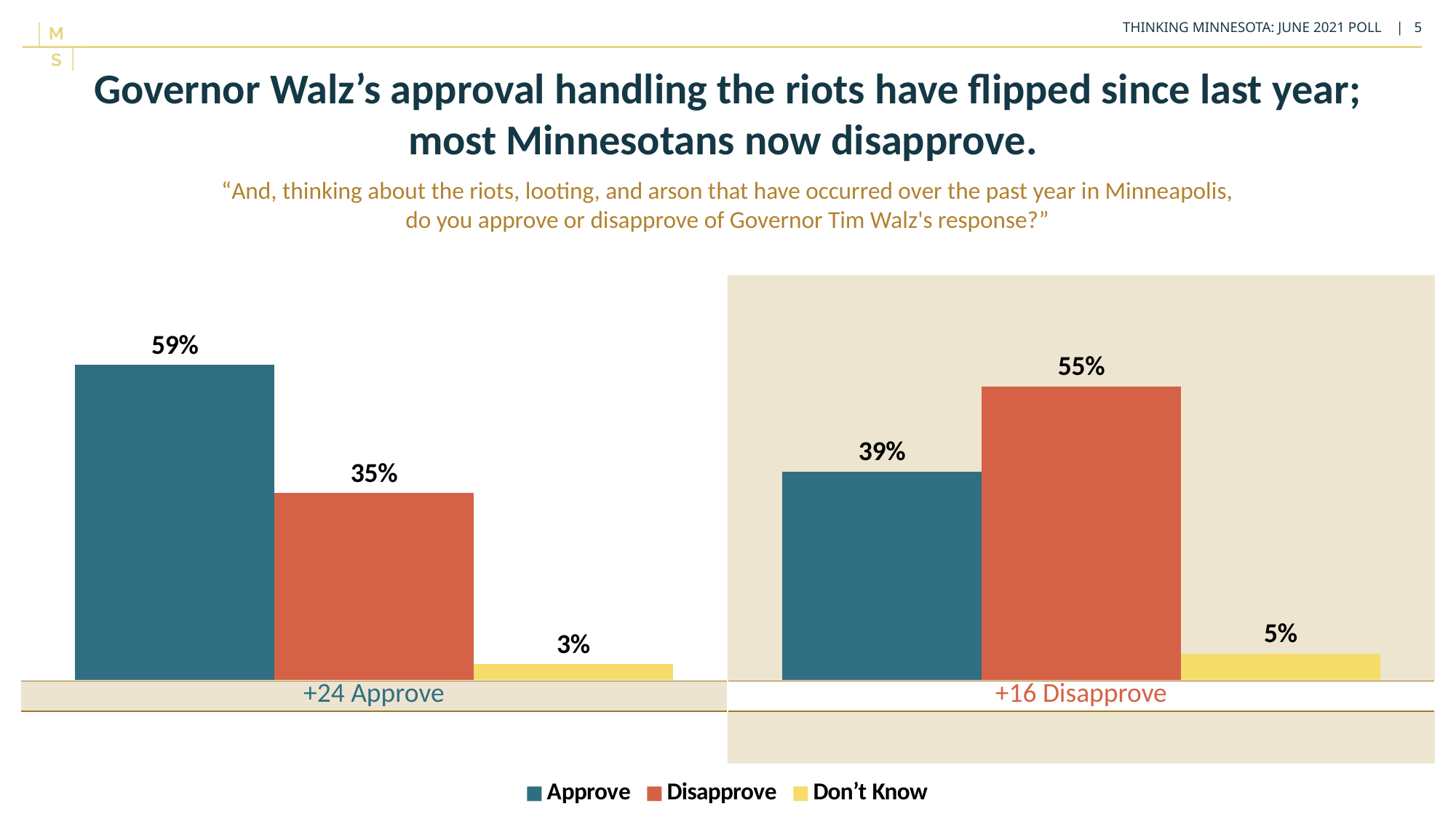
In the group labeled "+16 Disapprove", what is the value for Don't Know? 5% How many series does the legend list? 3 In the group labeled "+24 Approve", what is the value for Disapprove? 35% In the group labeled "+16 Disapprove", what is the value for Disapprove? 55% What kind of chart is shown on the slide? Bar chart In the group labeled "+16 Disapprove", what is the value for Approve? 39% Which is larger: Approve in the left group or Approve in the right group? Approve in the left group What is the difference between Disapprove and Approve in the group labeled "+16 Disapprove"? 16% Which series has the lowest value in the group labeled "+16 Disapprove"? Don't Know Which series has the highest value in the group labeled "+24 Approve"? Approve In the group labeled "+24 Approve", what is the value for Approve? 59% What is the difference between Approve and Disapprove in the group labeled "+24 Approve"? 24%